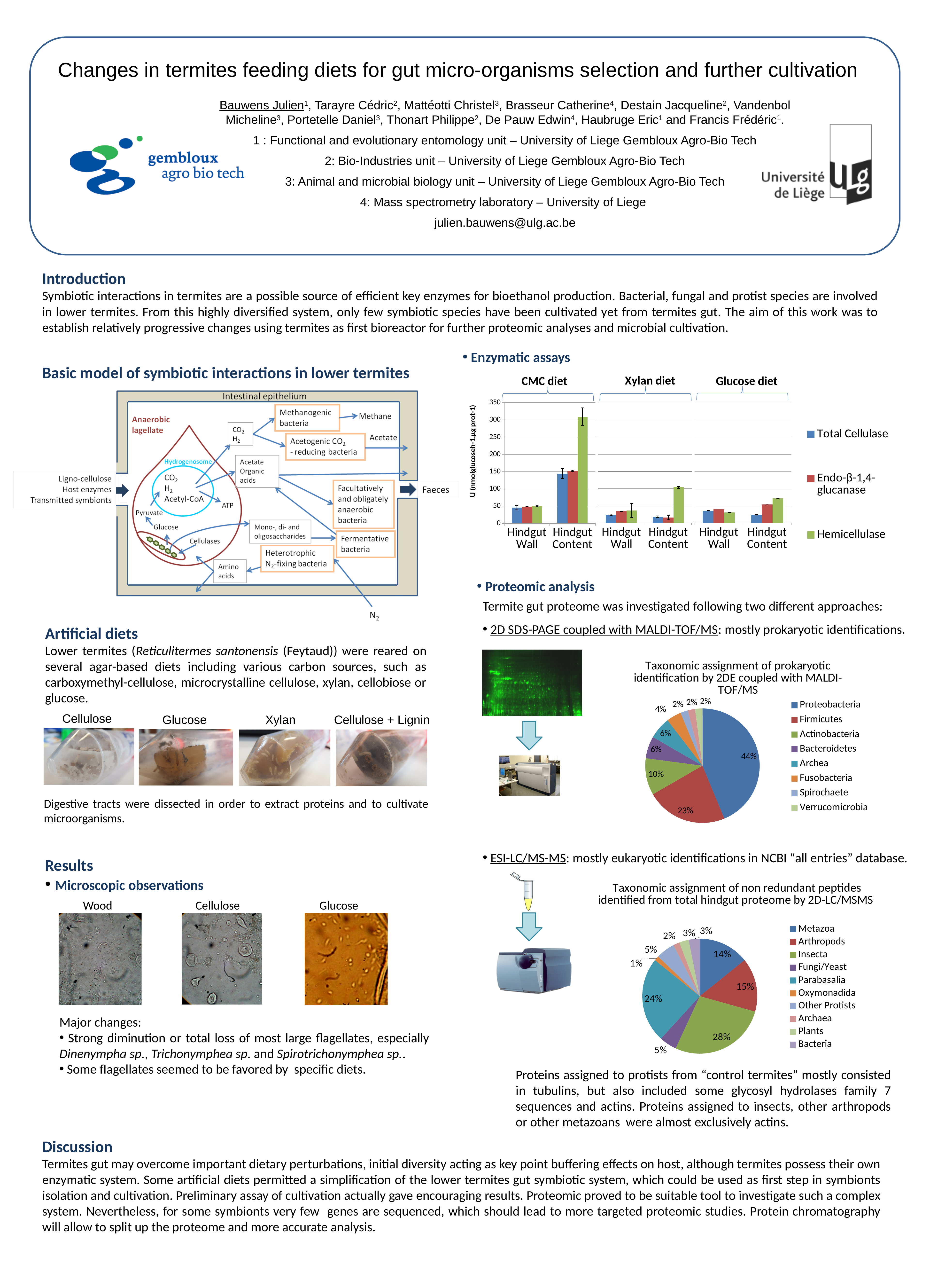
In the Enzymatic assays chart, which series has the tallest bar for Hindgut Content under the Xylan diet? Hemicellulase In the Enzymatic assays chart, which diet has the highest Hemicellulase value for Hindgut Content? CMC diet In the Enzymatic assays bar chart, how many series does the legend list? 3 In the pie chart of non redundant peptides identified from total hindgut proteome by 2D-LC/MSMS, what is the difference between the Insecta share and the Metazoa share? 14% In the Enzymatic assays chart, is the Total Cellulase value for Hindgut Wall under the CMC diet greater or less than 100? less In the pie chart of non redundant peptides identified from total hindgut proteome by 2D-LC/MSMS, what share is Parabasalia? 24% In the pie chart of prokaryotic identification by 2DE coupled with MALDI-TOF/MS, what share is Firmicutes? 23% What kind of chart is the Enzymatic assays chart? bar chart In the pie chart of non redundant peptides identified from total hindgut proteome by 2D-LC/MSMS, which group has the largest share? Insecta In the pie chart of prokaryotic identification by 2DE coupled with MALDI-TOF/MS, what share is Proteobacteria? 44% In the Enzymatic assays chart, is the Hemicellulase value for Hindgut Content under the CMC diet greater or less than 250? greater